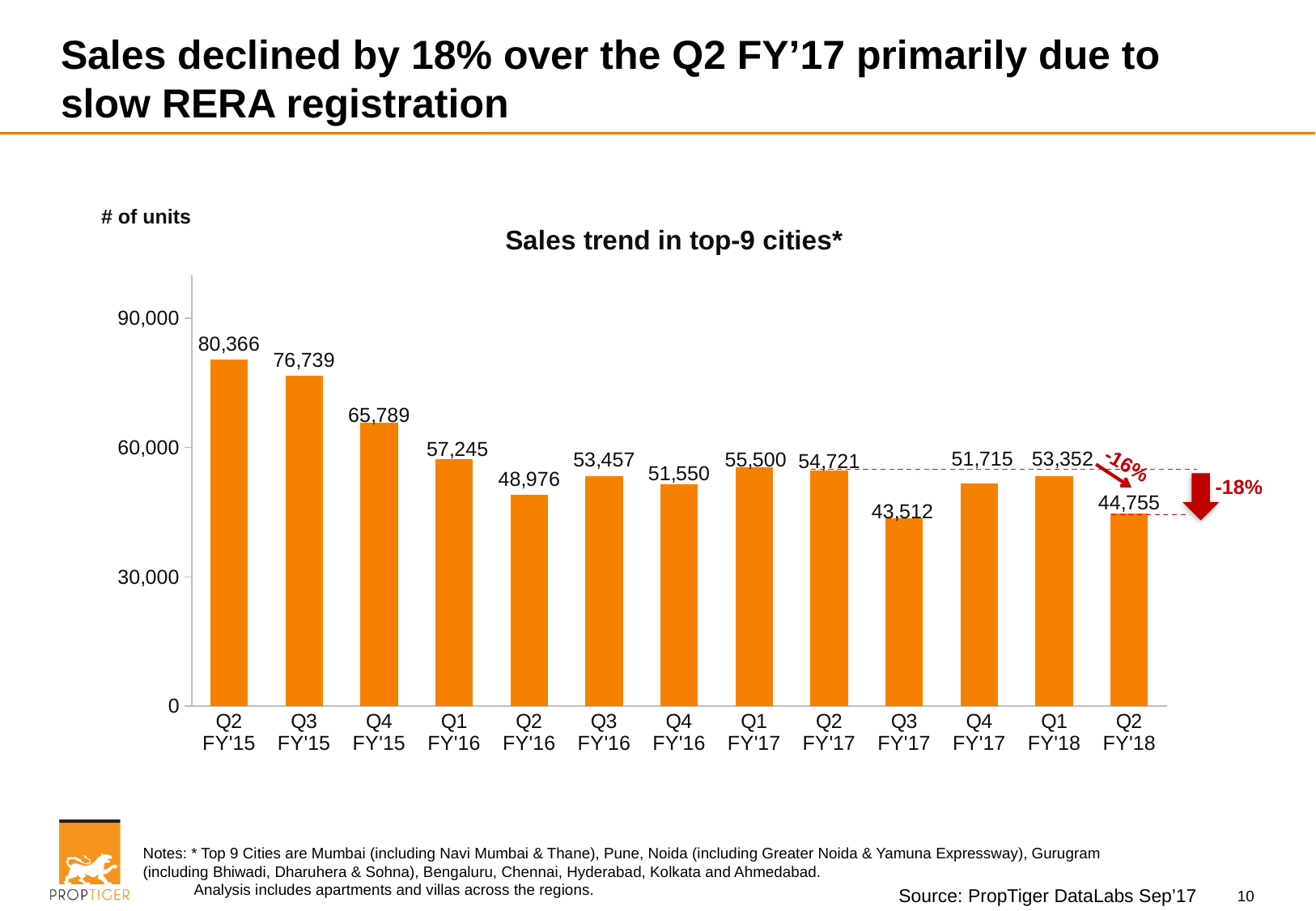
How many quarters are shown on the x axis? 13 What kind of chart is shown on the slide? Bar chart What is the value for Q3 FY'17? 43,512 Which quarter has the lowest number of units sold? Q3 FY'17 What is the difference in units between Q1 FY'18 and Q2 FY'18? 8,597 What is the number of units sold in Q2 FY'17? 54,721 What is the title of the chart? Sales trend in top-9 cities* Which quarter has the highest number of units sold? Q2 FY'15 What is the number of units sold in Q2 FY'18? 44,755 Which is larger, the value for Q1 FY'17 or the value for Q4 FY'16? Q1 FY'17 What is the difference in units between Q2 FY'17 and Q2 FY'18? 9,966 Is the value for Q4 FY'15 greater or less than 60,000? greater